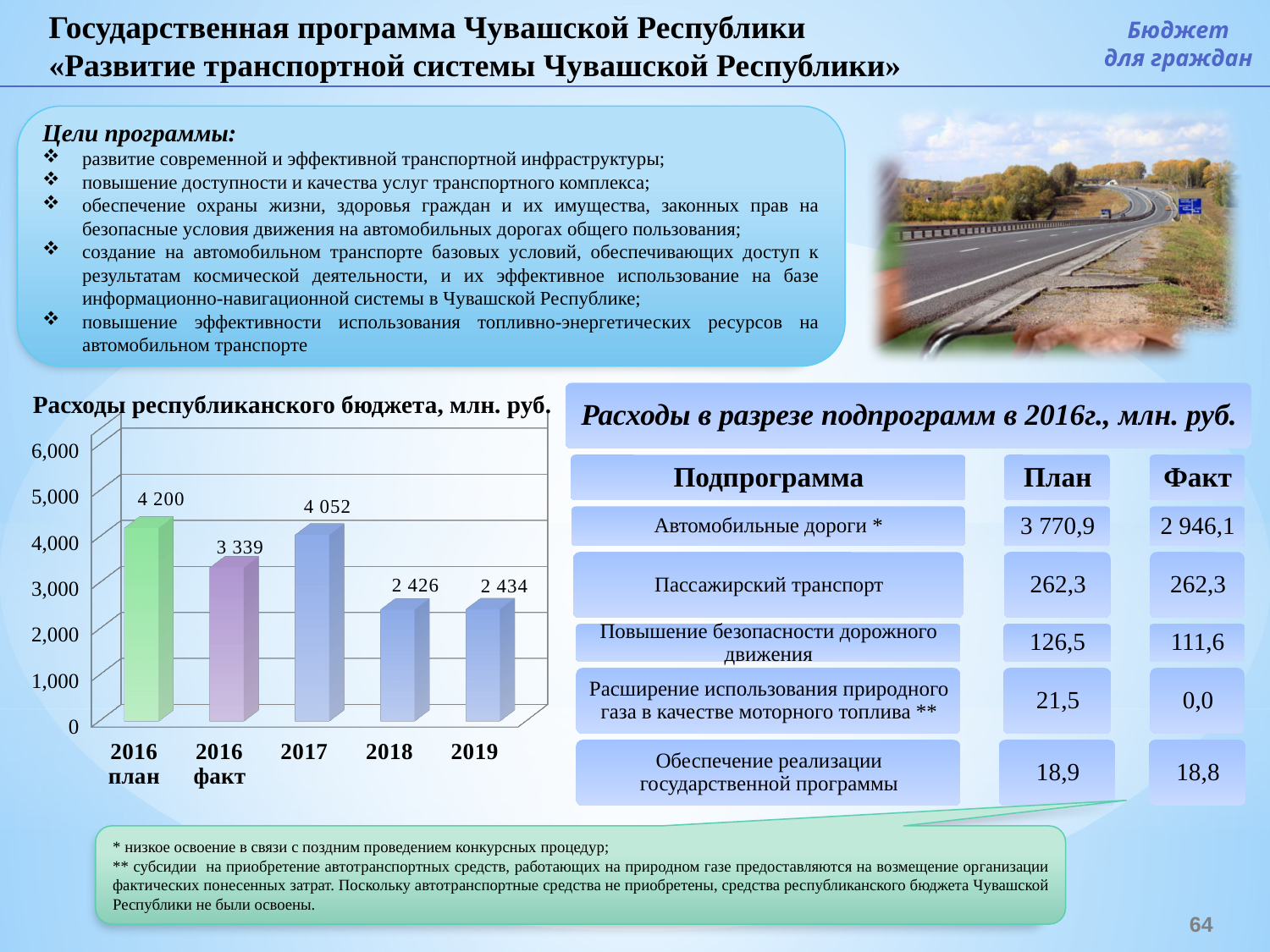
Which is larger in the chart 'Расходы республиканского бюджета, млн. руб.': the value for 2017 or the value for 2016 факт? 2017 What is the difference between the 2016 план and 2016 факт values in the chart 'Расходы республиканского бюджета, млн. руб.'? 861 Which category has the highest value in the chart 'Расходы республиканского бюджета, млн. руб.'? 2016 план Is the value for 2018 in the chart 'Расходы республиканского бюджета, млн. руб.' greater or less than 3,000? less How many categories are shown on the x axis of the chart 'Расходы республиканского бюджета, млн. руб.'? 5 What is the value for 2016 план in the chart 'Расходы республиканского бюджета, млн. руб.'? 4 200 What is the value for 2016 факт in the chart 'Расходы республиканского бюджета, млн. руб.'? 3 339 Which category has the lowest value in the chart 'Расходы республиканского бюджета, млн. руб.'? 2018 What kind of chart is 'Расходы республиканского бюджета, млн. руб.'? bar chart What is the value for 2019 in the chart 'Расходы республиканского бюджета, млн. руб.'? 2 434 What is the value for 2017 in the chart 'Расходы республиканского бюджета, млн. руб.'? 4 052 What is the title of the chart on the left side of the slide? Расходы республиканского бюджета, млн. руб.